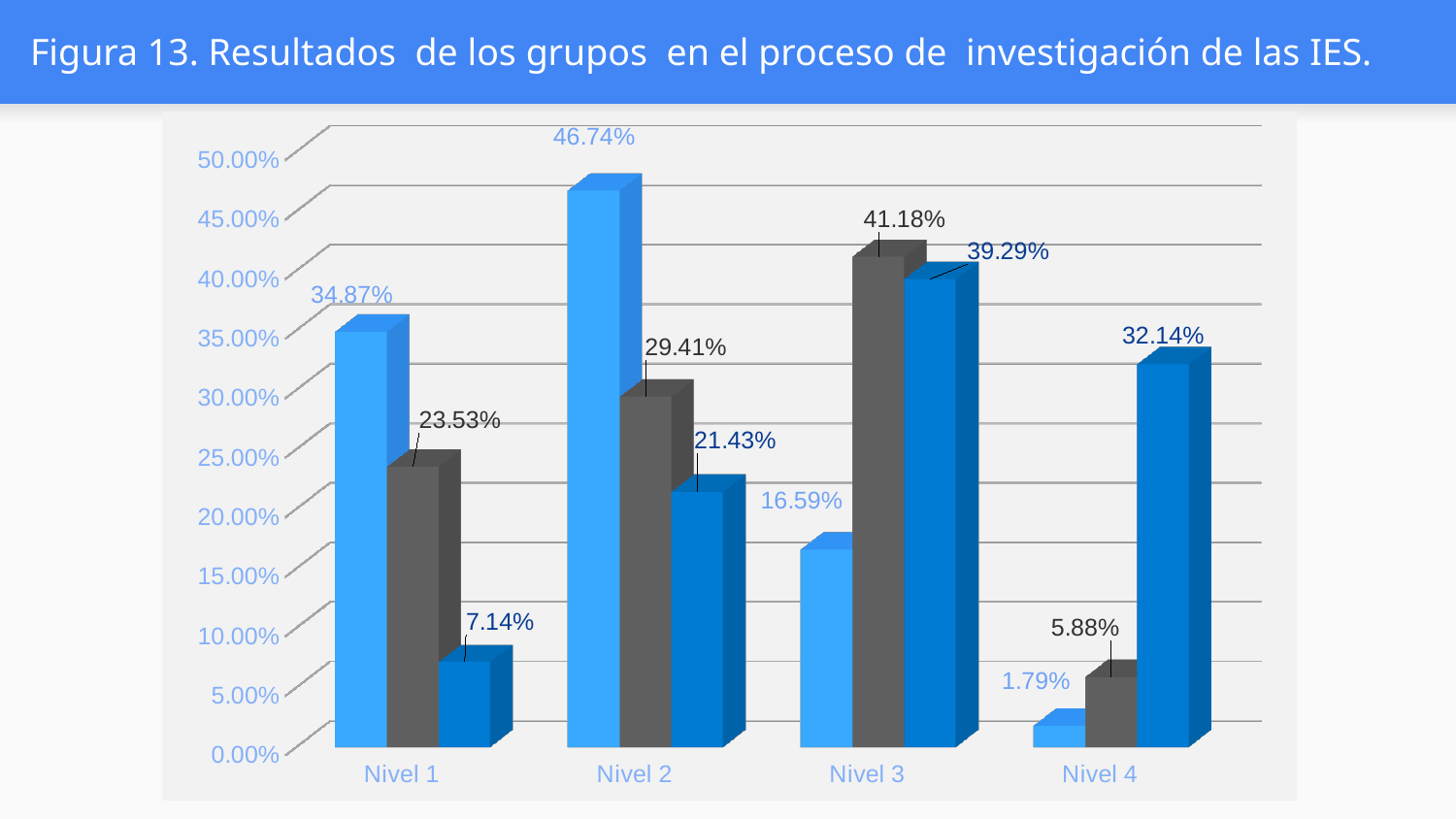
Is the dark blue bar for Nivel 2 greater or less than 25.00%? less What kind of chart is shown on the slide? Bar chart What is the value of the dark blue bar for Nivel 4? 32.14% What is the title of the chart? Figura 13. Resultados de los grupos en el proceso de investigación de las IES. What is the value of the light blue bar for Nivel 2? 46.74% What is the value of the light blue bar for Nivel 4? 1.79% For Nivel 3, which is larger: the dark grey bar or the light blue bar? The dark grey bar Which category has the highest light blue bar? Nivel 2 What is the value of the dark grey bar for Nivel 3? 41.18% Which category has the lowest dark blue bar? Nivel 1 What is the difference between the light blue bar and the dark grey bar for Nivel 1? 11.34% How many categories are shown on the x axis? 4